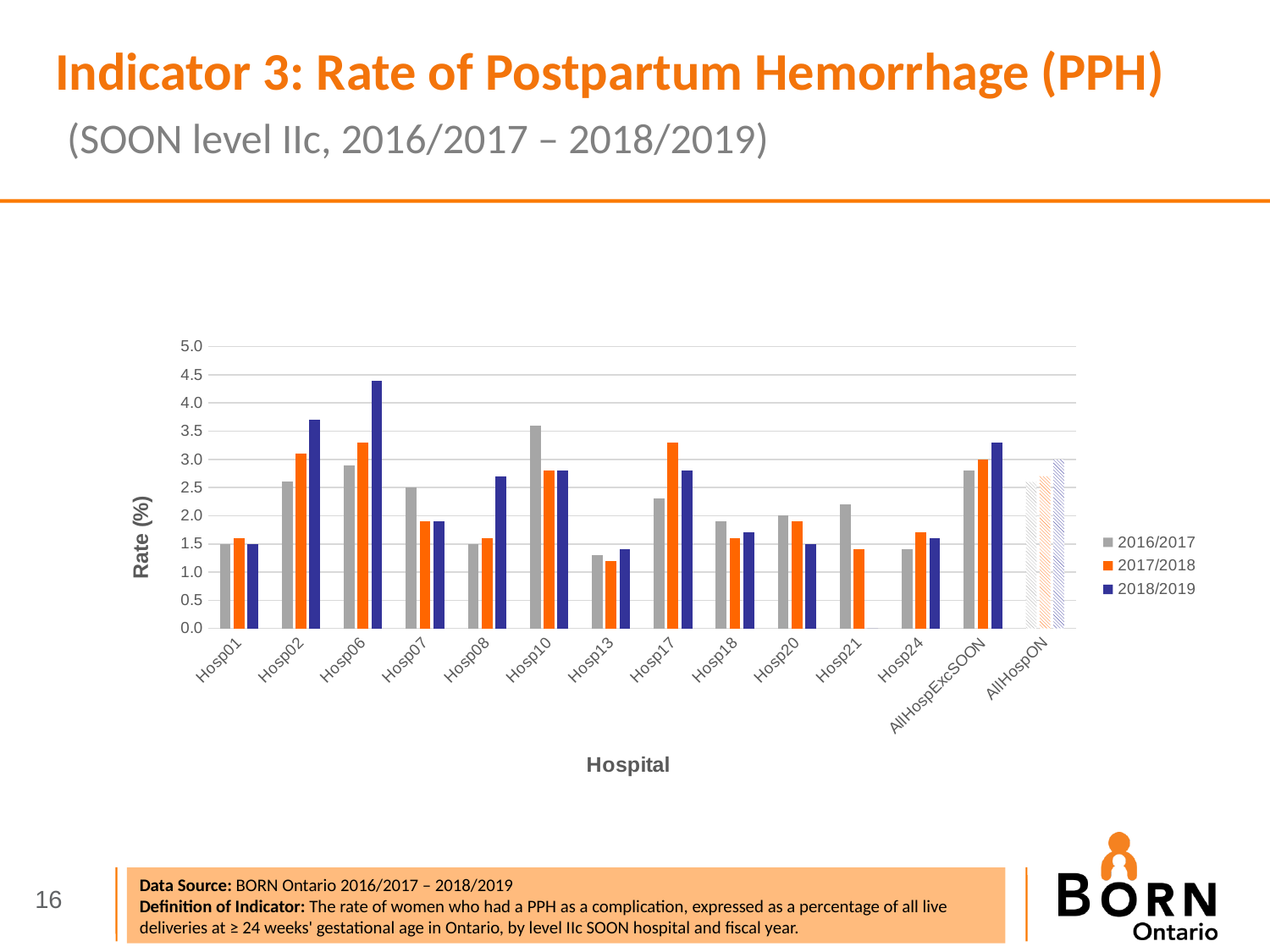
How many hospital categories are shown on the x axis? 14 Which hospital has no 2018/2019 bar plotted? Hosp21 Is the 2017/2018 value for Hosp13 greater or less than 1.5? less Which hospital has the highest 2018/2019 PPH rate? Hosp06 Is the 2017/2018 value for Hosp17 greater or less than 3.0? greater For Hosp02, which is larger: the 2016/2017 value or the 2018/2019 value? 2018/2019 How many series does the legend list? 3 What is the title of the vertical axis? Rate (%) For Hosp02, do the values rise or fall from 2016/2017 to 2018/2019? rise Is the 2016/2017 value for Hosp10 greater or less than 3.0? greater What kind of chart is shown on the slide? Bar chart